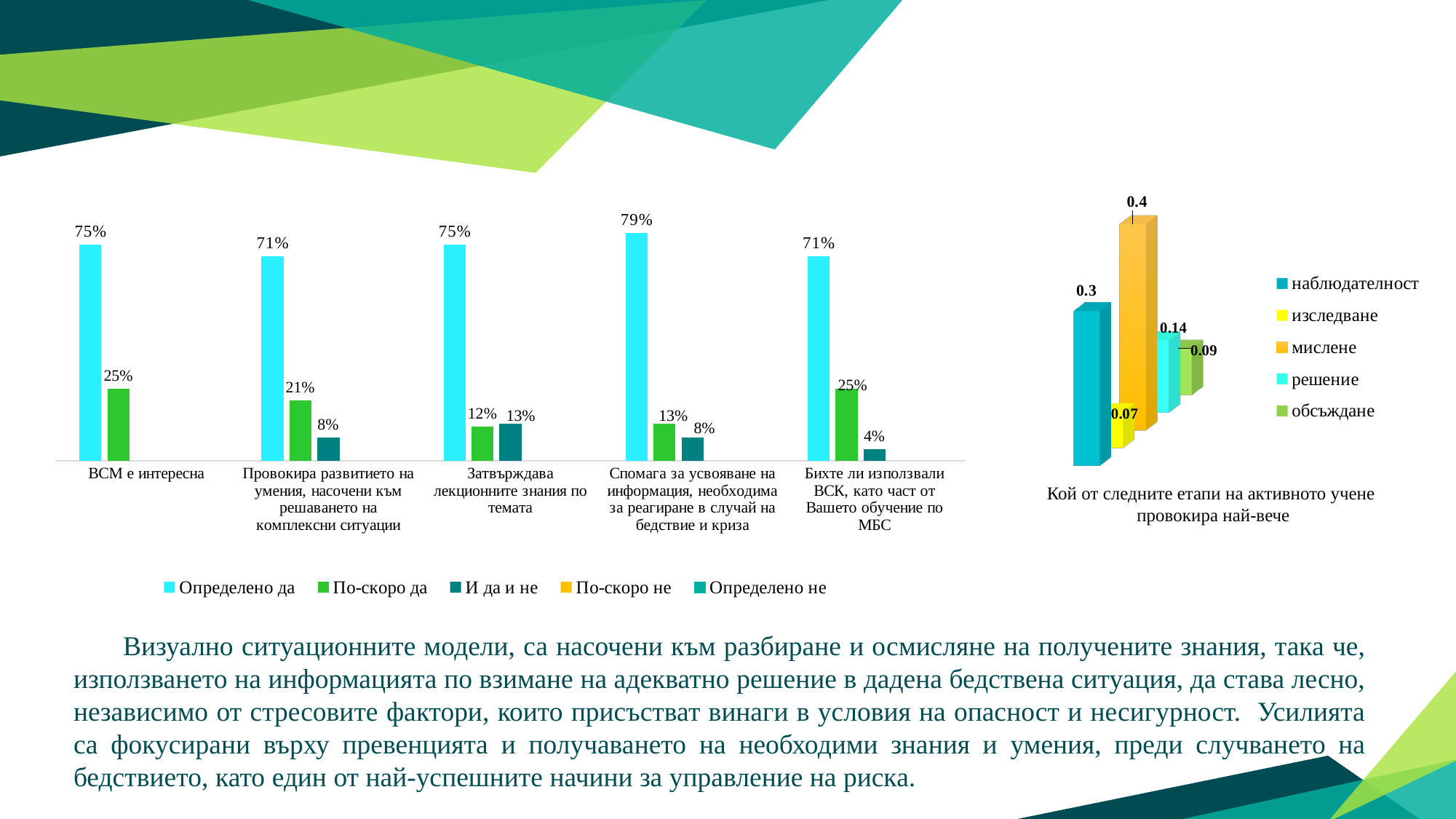
In the chart titled "Кой от следните етапи на активното учене провокира най-вече", what is the difference between "наблюдателност" and "решение"? 0.16 How many categories are shown on the x axis of the left bar chart? 5 In the chart titled "Кой от следните етапи на активното учене провокира най-вече", what is the value for "мислене"? 0.4 In the left bar chart, what is the value of "Определено да" for "ВСМ е интересна"? 75% What kind of chart is the chart on the left of the slide? bar chart In the left bar chart, what is the value of "И да и не" for "Затвърждава лекционните знания по темата"? 13% How many series does the legend of the left bar chart list? 5 In the left bar chart, which category has the highest "Определено да" value? Спомага за усвояване на информация, необходима за реагиране в случай на бедствие и криза How many series does the legend of the chart titled "Кой от следните етапи на активното учене провокира най-вече" list? 5 In the left bar chart, what is the difference between the "Определено да" and "По-скоро да" values for "Бихте ли използвали ВСК, като част от Вашето обучение по МБС"? 46% In the chart titled "Кой от следните етапи на активното учене провокира най-вече", which series has the lowest value? изследване In the left bar chart, which is larger for "Затвърждава лекционните знания по темата": "По-скоро да" or "И да и не"? И да и не